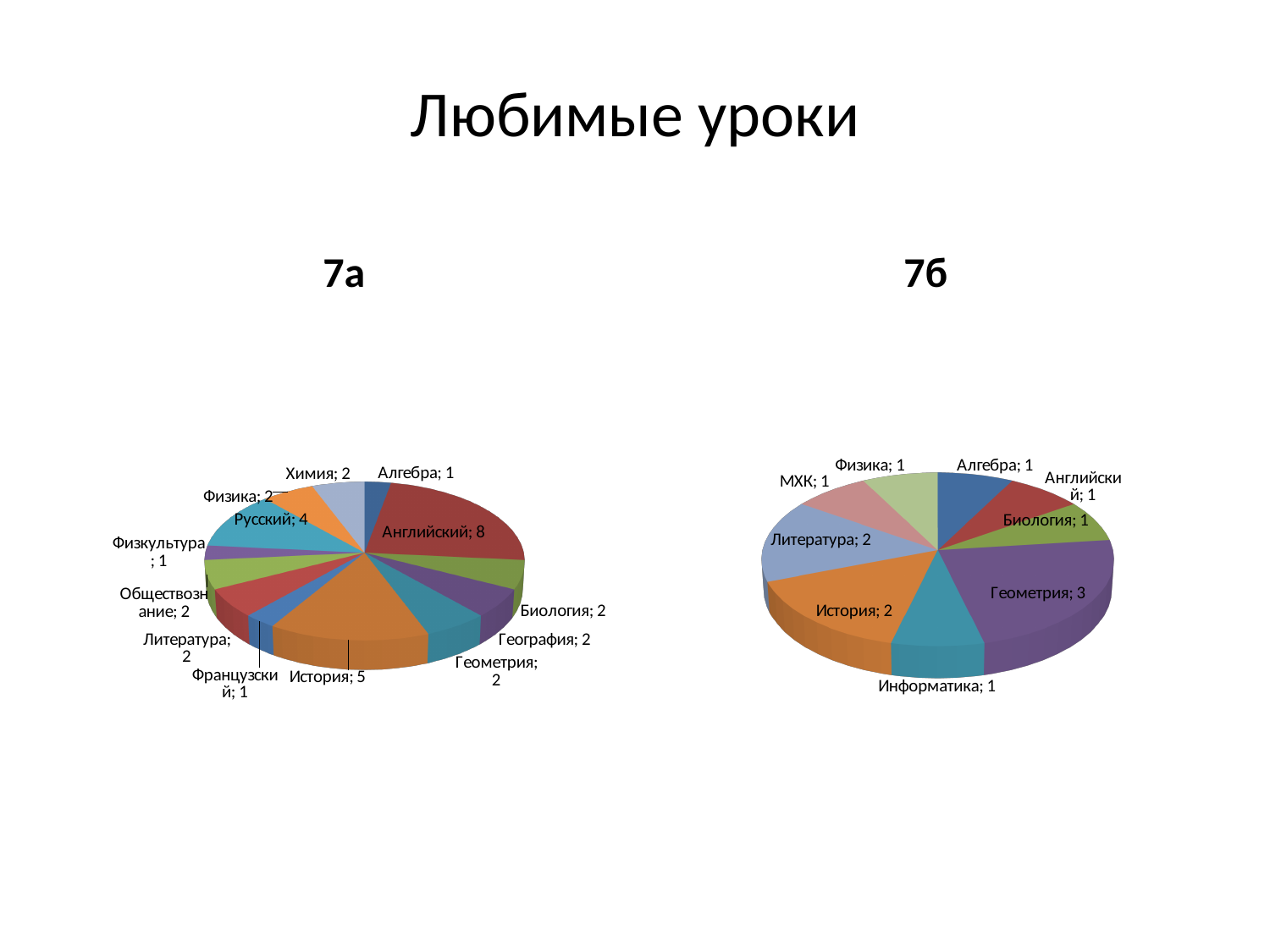
How many slices does the 7а chart have? 13 In the 7а chart, which subject has the highest value? Английский In the 7б chart, what is the difference between the values for Геометрия and История? 1 In the 7а chart, what is the difference between the values for Английский and Русский? 4 How many slices does the 7б chart have? 9 What type of chart is used for 7а? Pie chart In the 7а chart, what is the value for Английский? 8 In the 7а chart, which is larger, История or Русский? История In the 7а chart, what is the value for История? 5 In the 7б chart, what is the value for Геометрия? 3 In the 7б chart, which subject has the highest value? Геометрия In the 7б chart, what is the value for Литература? 2